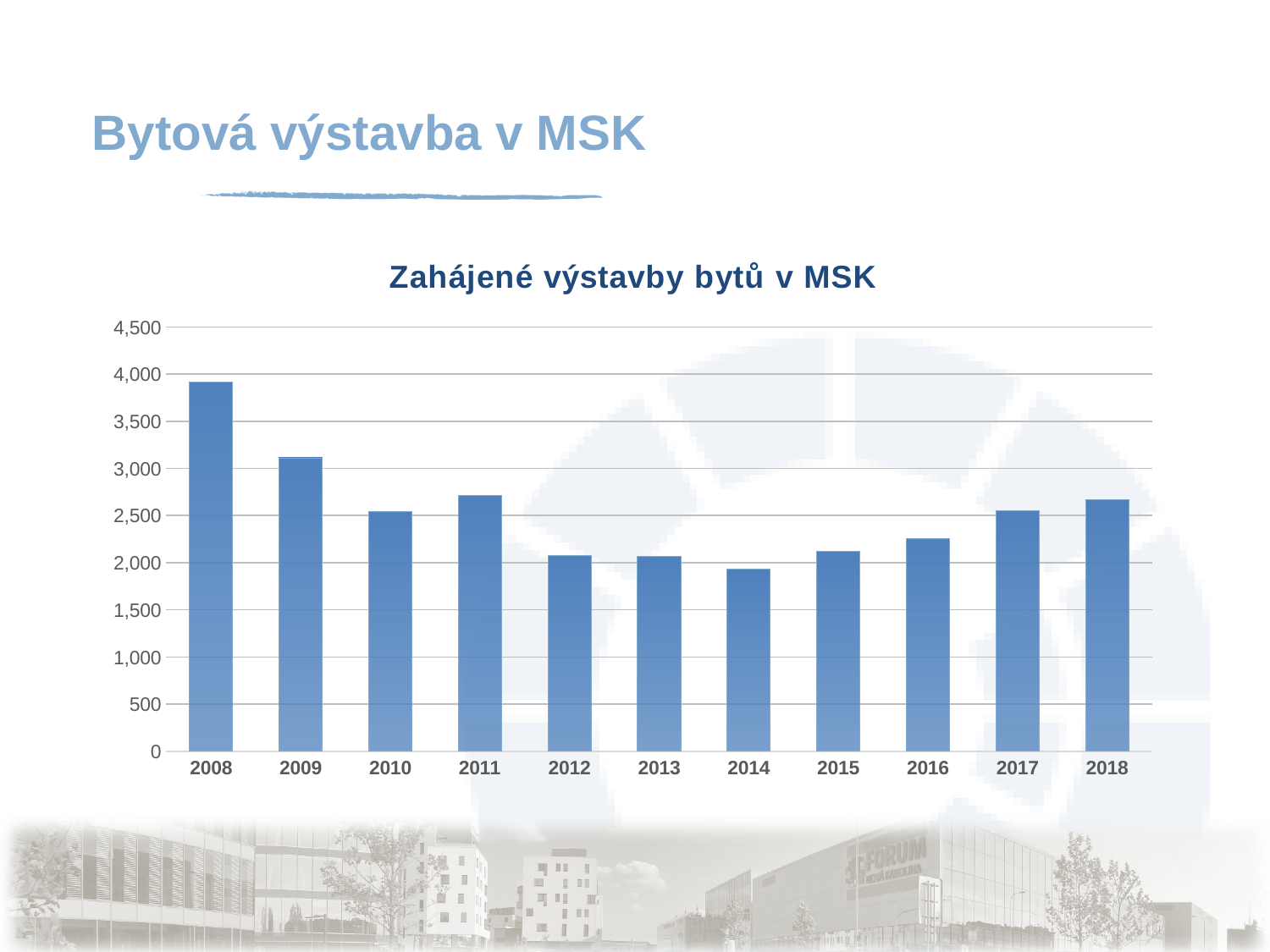
Do the values generally rise or fall from 2008 to 2014? fall How many years are shown on the x axis of the chart? 11 Is the value for 2014 greater or less than 2,000? less Which is larger, the value for 2011 or the value for 2012? 2011 Which year has the lowest value in the chart? 2014 What kind of chart is shown on the slide? bar chart Is the value for 2008 greater or less than 3,500? greater Which is larger, the value for 2008 or the value for 2009? 2008 Is the value for 2016 greater or less than 2,500? less What is the title of the chart? Zahájené výstavby bytů v MSK Which year has the highest value in the chart? 2008